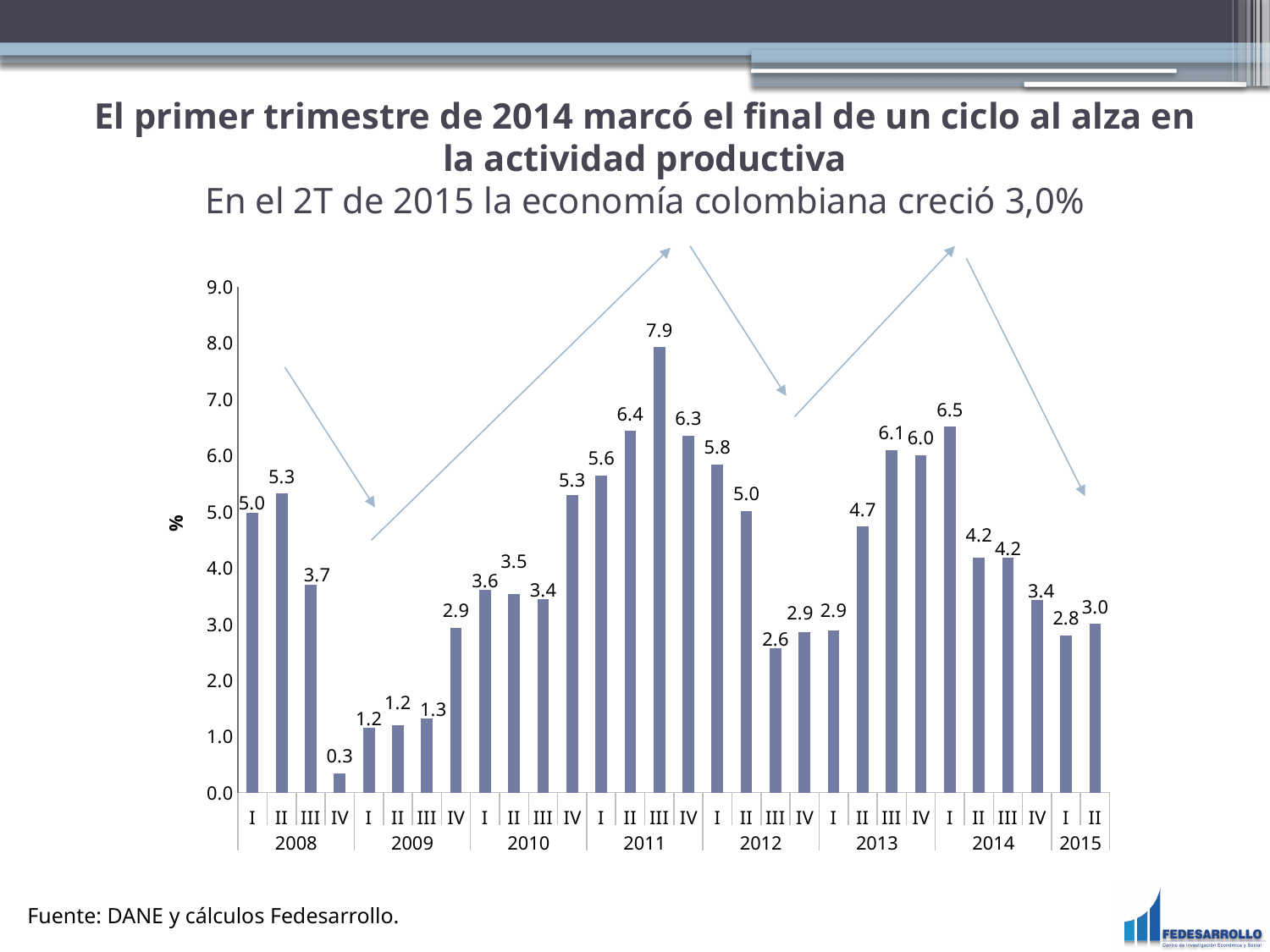
What is the value for quarter III of 2011? 7.9 What is the value for quarter II of 2015? 3.0 What is the value for quarter IV of 2008? 0.3 What kind of chart is shown on the slide? bar chart What is the difference between the value for quarter I of 2014 and the value for quarter II of 2014? 2.3 Is the value for quarter II of 2011 greater or less than 6.0? greater Which quarter has the highest value in the chart? III 2011 How many quarterly bars are plotted in the chart? 30 What is the label on the vertical axis of the chart? % Which quarter has the lowest value in the chart? IV 2008 Which is larger, the value for quarter III of 2013 or the value for quarter IV of 2013? III 2013 Do the values rise or fall from quarter I of 2014 to quarter I of 2015? fall